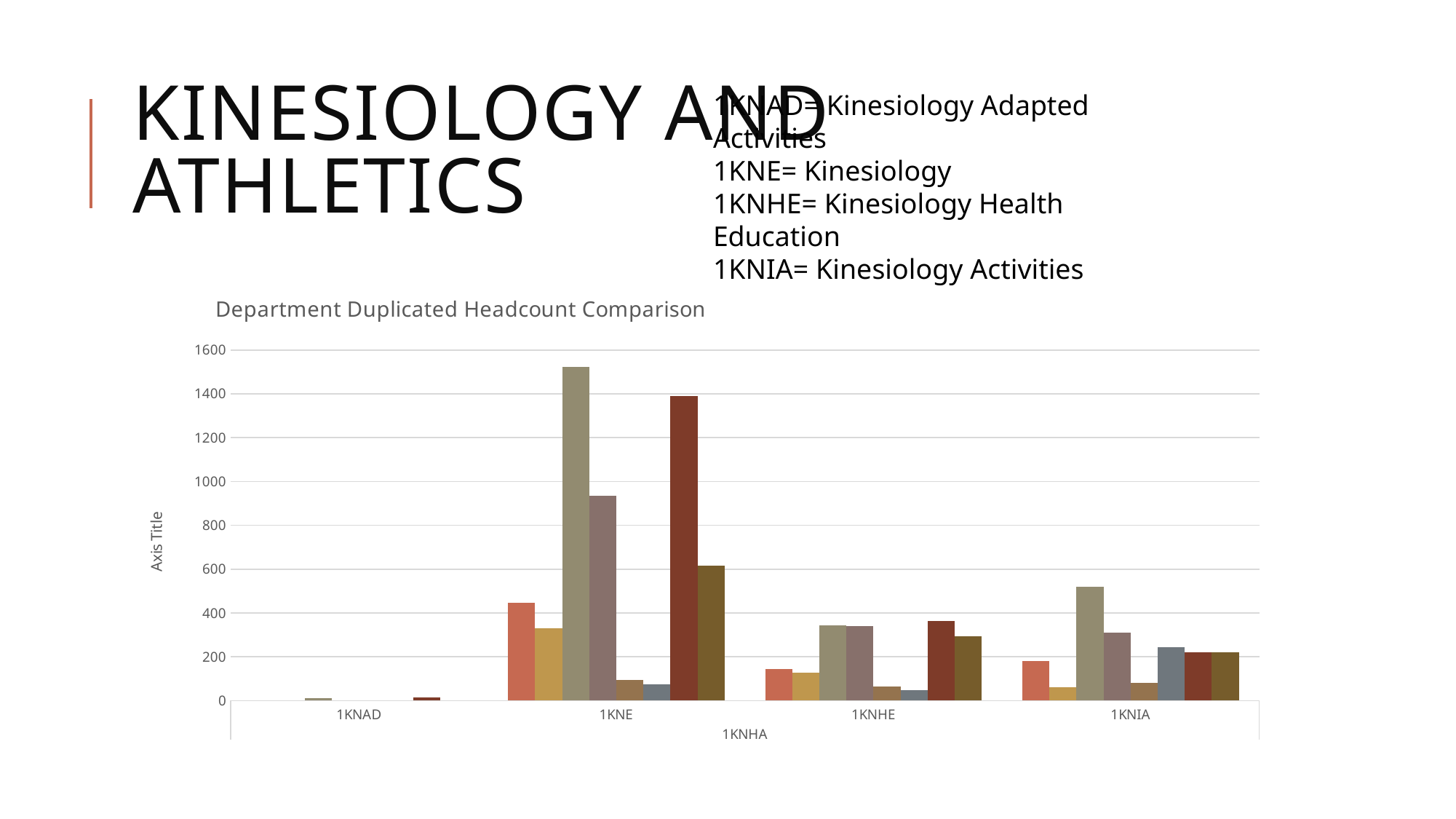
How many categories are shown on the x axis of the chart? 4 Is the tallest bar in the 1KNE group taller than the tallest bar in the 1KNIA group? yes Which category has the lowest bars overall in the chart? 1KNAD What is the title of the chart? Department Duplicated Headcount Comparison Is the tallest bar in the 1KNE group greater or less than 1400? greater Is the tallest bar in the 1KNIA group greater or less than 600? less Is the tallest bar in the 1KNAD group greater or less than 200? less What kind of chart is shown on the slide? bar chart How many bars are plotted in the 1KNIA group? 8 What is the x-axis title of the chart? 1KNHA Which category contains the tallest bar in the chart? 1KNE